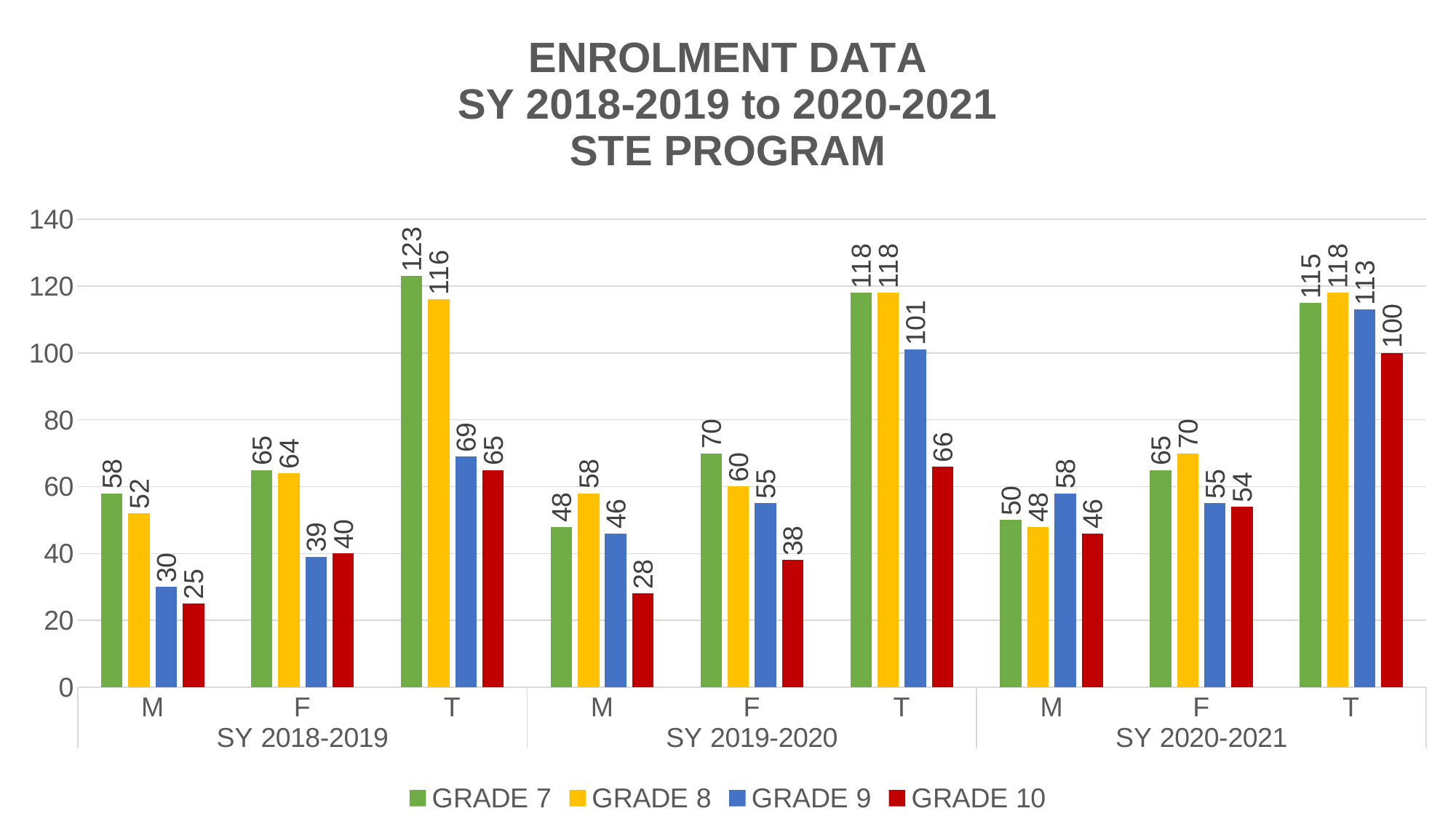
How does the Grade 10 value for T change from SY 2018-2019 to SY 2020-2021? It rises What is the Grade 10 value for T in SY 2020-2021? 100 Which grade has the lowest value for M in SY 2019-2020? Grade 10 What is the Grade 7 value for M in SY 2018-2019? 58 What colour represents Grade 9 in the chart? Blue What is the Grade 9 value for F in SY 2019-2020? 55 Is the Grade 8 value for T in SY 2020-2021 greater or less than 100? greater Which is larger: the Grade 9 value for M in SY 2020-2021 or the Grade 9 value for M in SY 2018-2019? SY 2020-2021 What kind of chart is shown on the slide? Bar chart What is the difference between the Grade 7 and Grade 10 values for T in SY 2019-2020? 52 Which grade has the highest value for T in SY 2018-2019? Grade 7 How many series does the legend list? 4